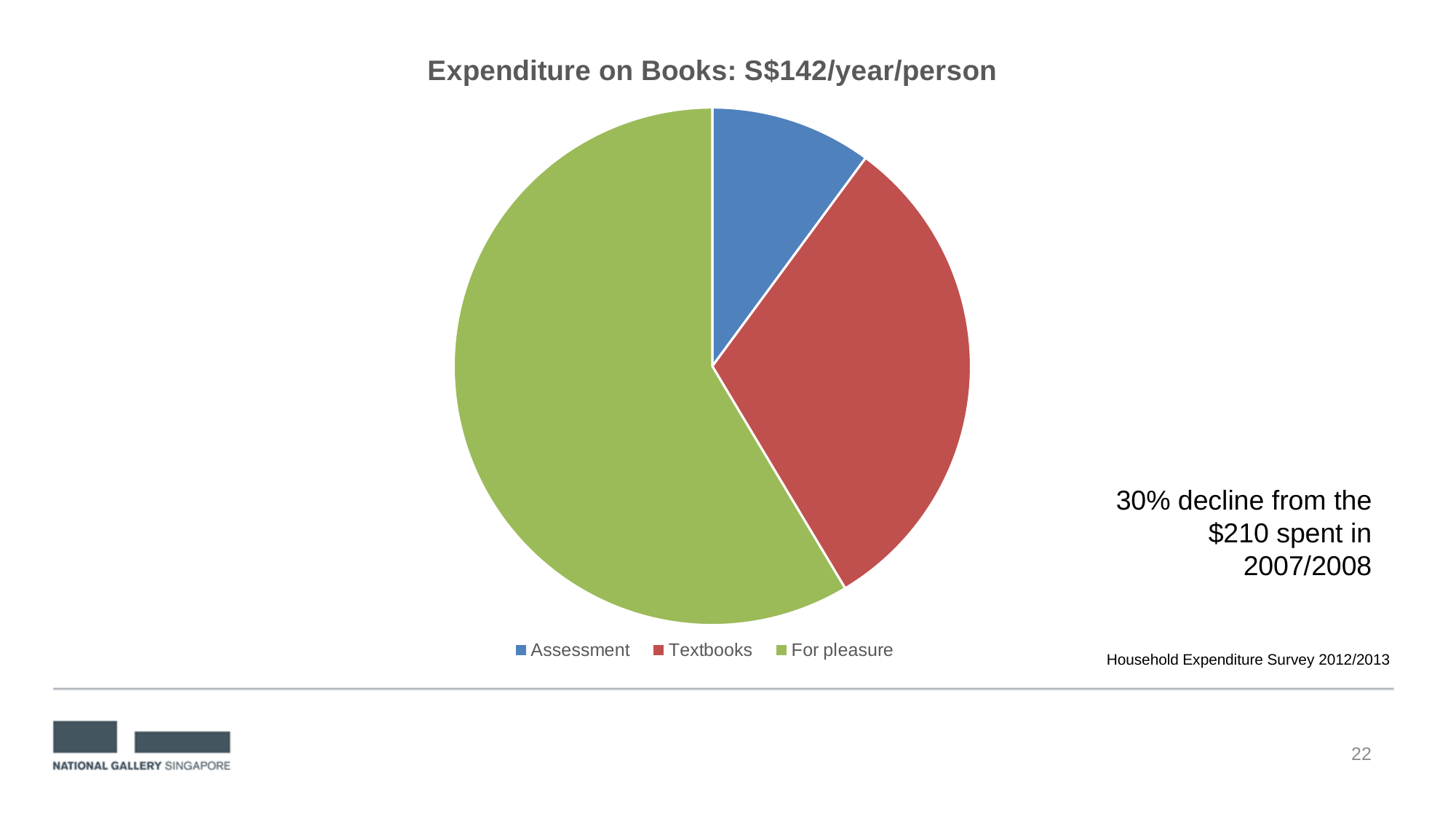
How many entries does the legend of the pie chart list? 3 Which slice is larger, For pleasure or Textbooks? For pleasure Which category has the smallest slice of the pie chart? Assessment Which category has the largest slice of the pie chart? For pleasure Which colour represents Textbooks in the pie chart? Red What is the title of the pie chart? Expenditure on Books: S$142/year/person How many slices does the pie chart have? 3 Does the For pleasure slice take up more or less than half of the pie? More Which slice is larger, Textbooks or Assessment? Textbooks What kind of chart is shown on the slide? Pie chart